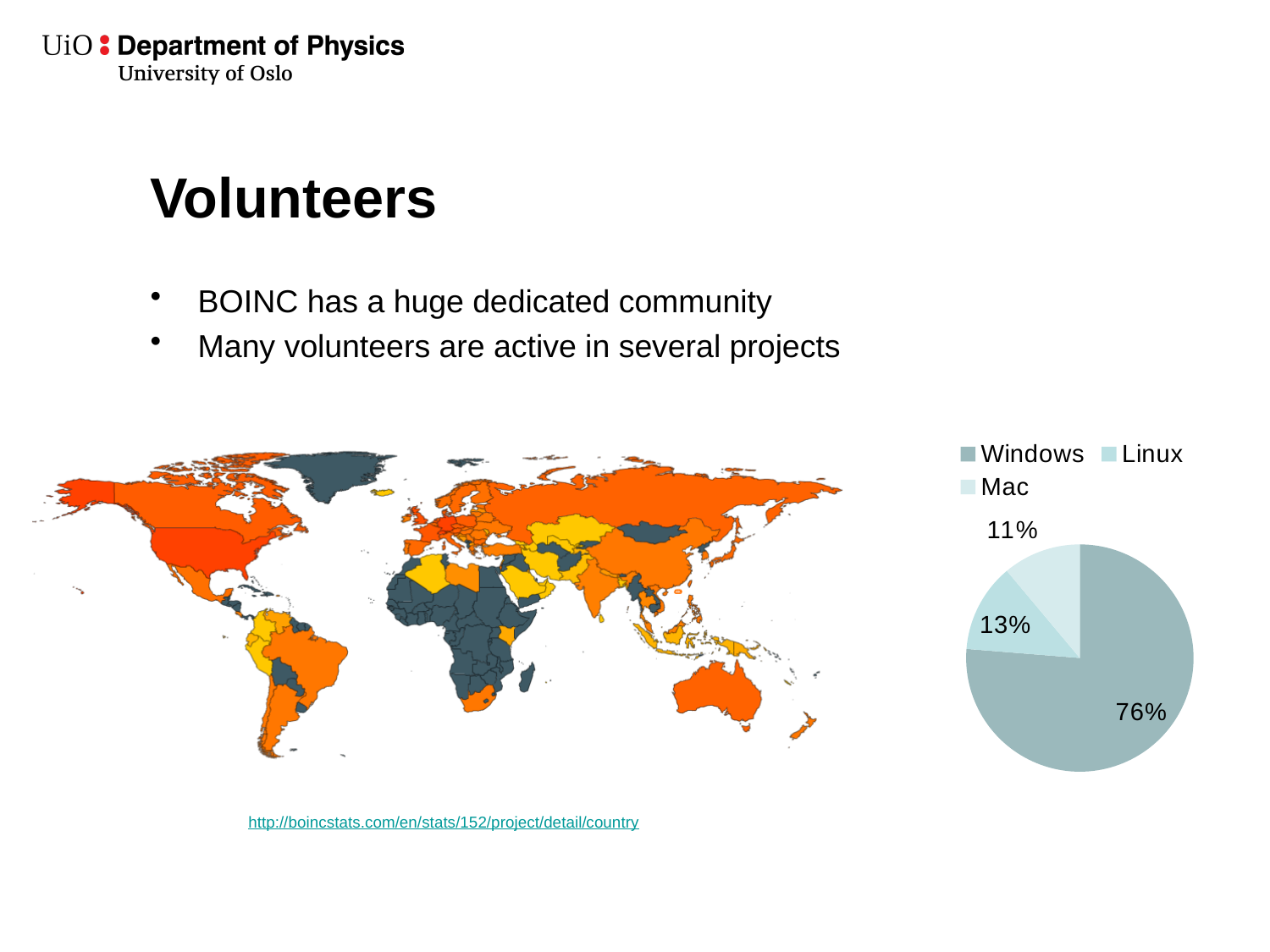
Which operating system has the largest slice in the pie chart? Windows Which operating system has the smallest slice in the pie chart? Mac Which legend entry is listed first in the pie chart legend? Windows What kind of chart is shown on the right of the slide? Pie chart What share of the pie chart is Windows? 76% Which slice is larger in the pie chart, Linux or Mac? Linux How many entries does the pie chart legend list? 3 What share of the pie chart is Linux? 13% What share of the pie chart is Mac? 11% What is the difference in percentage points between the Windows and Linux slices? 63 How many slices does the pie chart have? 3 What is the difference in percentage points between the Linux and Mac slices? 2